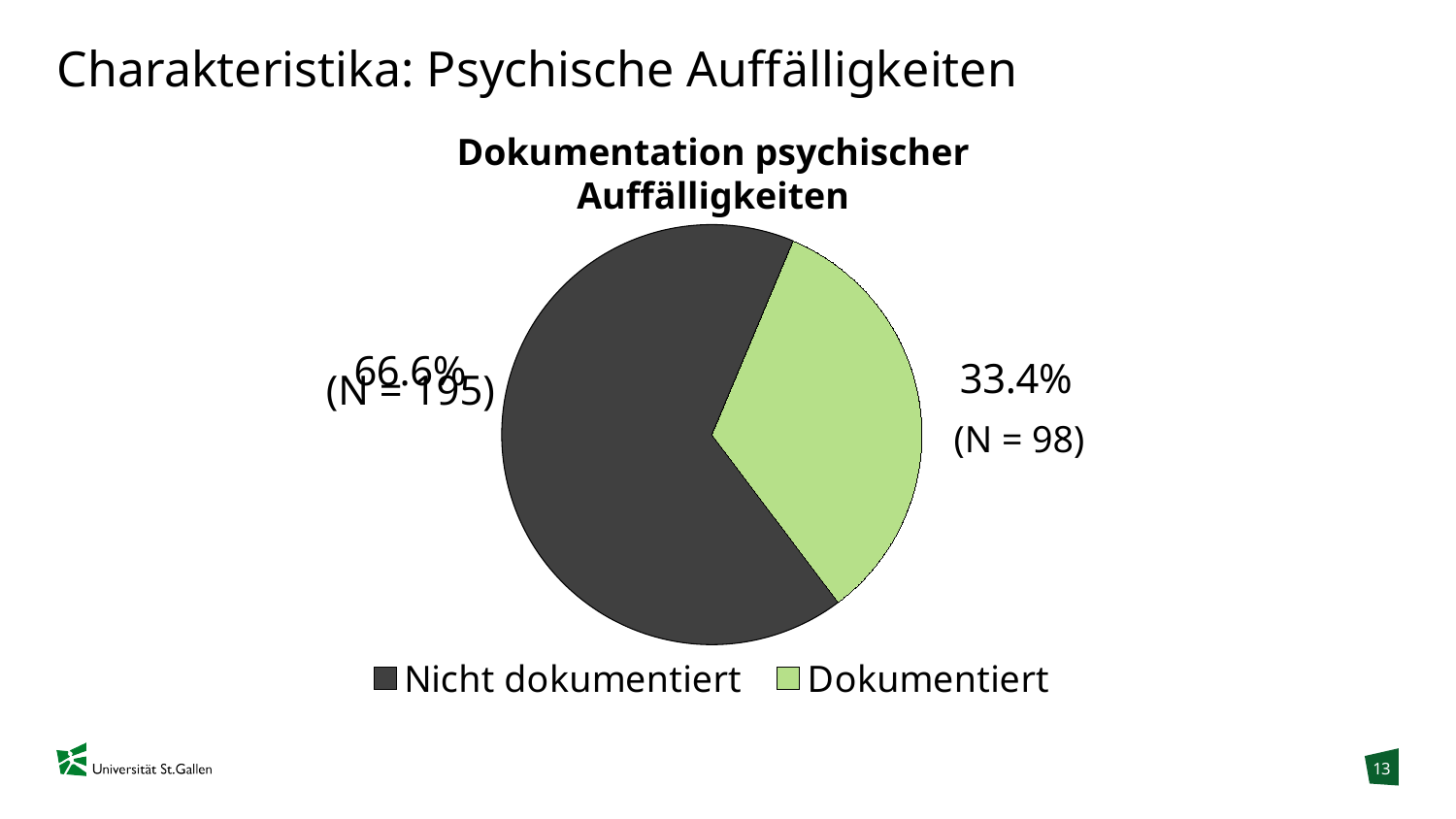
What is the difference in percentage points between the 'Nicht dokumentiert' and 'Dokumentiert' slices? 33.2 What kind of chart is shown on the slide? pie chart How many entries does the legend list? 2 What percentage share does the 'Nicht dokumentiert' slice have? 66.6% Which colour represents the 'Dokumentiert' slice? light green What is the N value shown for the 'Nicht dokumentiert' slice? N = 195 How many slices does the pie chart have? 2 What is the N value shown for the 'Dokumentiert' slice? N = 98 What percentage share does the 'Dokumentiert' slice have? 33.4% Which slice is the smallest in the pie chart? Dokumentiert What is the title of the chart? Dokumentation psychischer Auffälligkeiten Which slice is the largest in the pie chart? Nicht dokumentiert